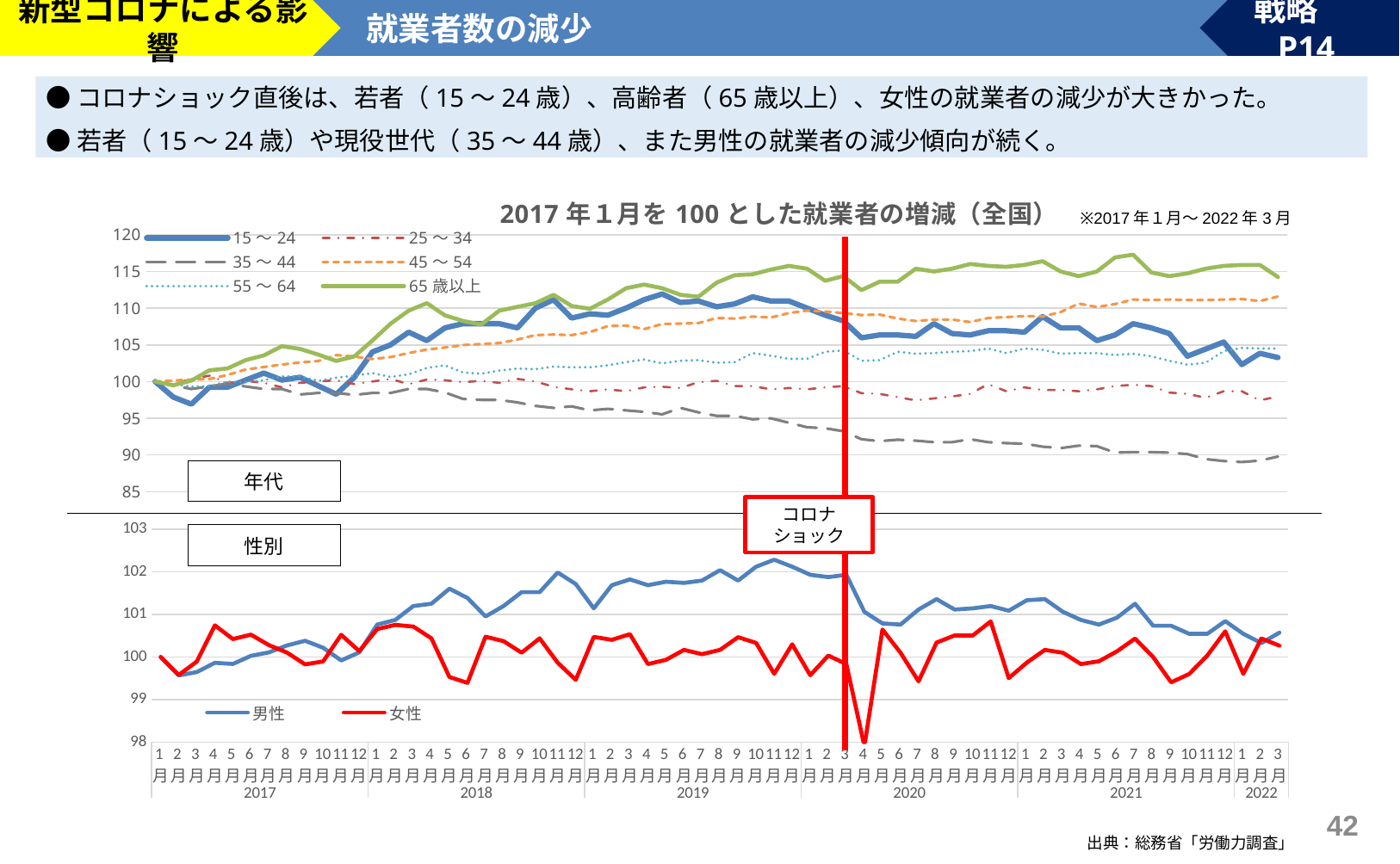
In the top chart (年代), is the value for 65歳以上 in 2022年3月 greater or less than 110? greater In the top chart (年代), is the value for 35～44 in 2022年3月 greater or less than 95? less What is the title of the top chart? 2017年1月を100とした就業者の増減（全国） In the top chart (年代), does the 35～44 line rise or fall overall from 2017 to 2022? Fall In the bottom chart (性別), is the value for 男性 in 2019年11月 greater or less than 102? greater In the top chart (年代), which age group has the lowest value at the end of the period (2022年3月)? 35～44 How many series does the legend of the top chart (年代) list? 6 How many series does the legend of the bottom chart (性別) list? 2 What kind of chart is the top chart labelled 年代? Line chart In the top chart (年代), which age group has the highest value at the end of the period (2022年3月)? 65歳以上 In the top chart (年代), which is higher in 2022年3月: 65歳以上 or 25～34? 65歳以上